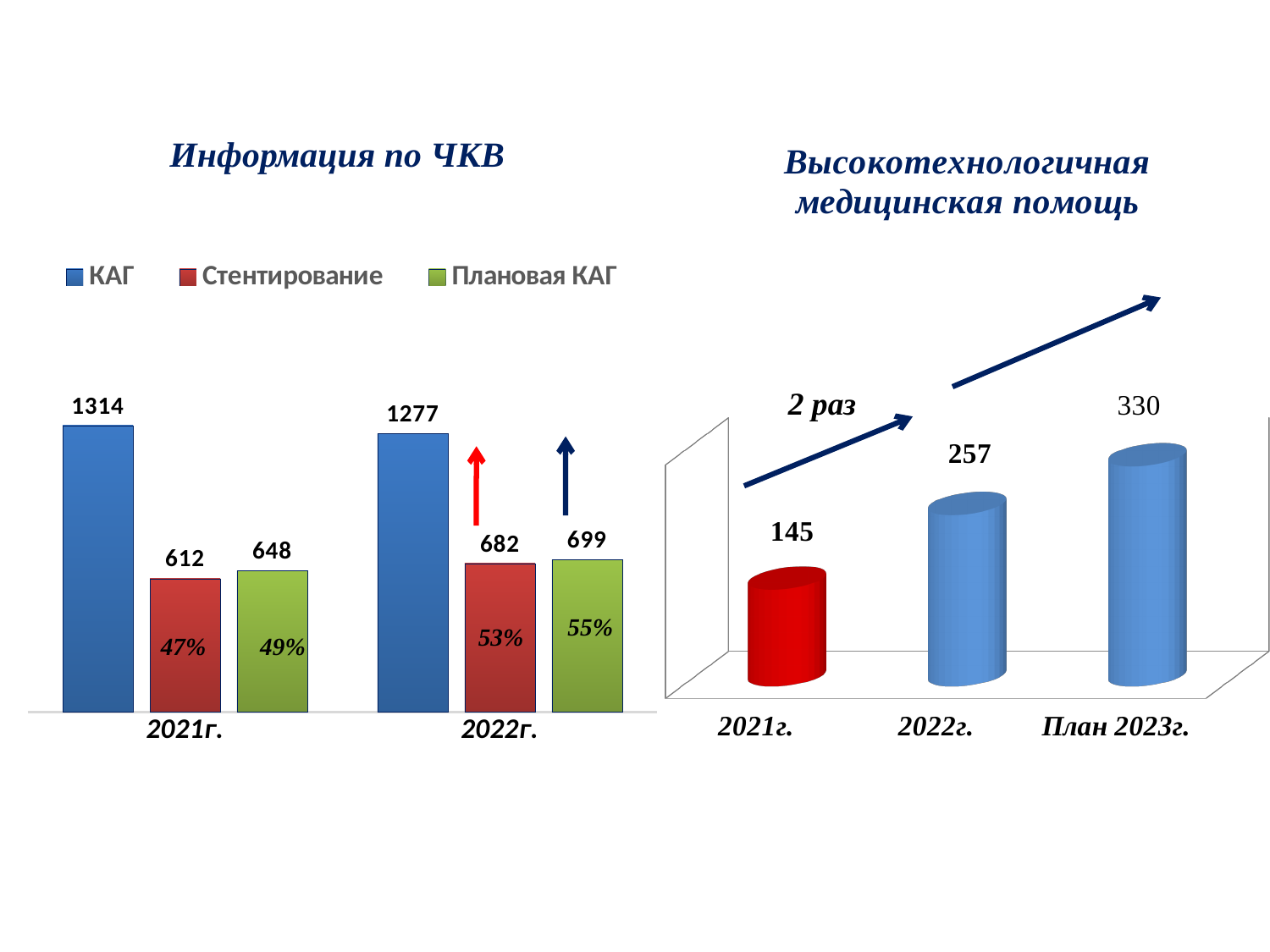
In the chart 'Высокотехнологичная медицинская помощь', what is the difference between План 2023г. and 2021г.? 185 In the chart 'Информация по ЧКВ', what is the value of Плановая КАГ for 2021г.? 648 In the chart 'Информация по ЧКВ', what is the value of КАГ for 2021г.? 1314 In the chart 'Высокотехнологичная медицинская помощь', how many categories are shown on the x axis? 3 In the chart 'Высокотехнологичная медицинская помощь', do the values rise or fall from 2021г. to План 2023г.? rise In the chart 'Высокотехнологичная медицинская помощь', what is the value for 2022г.? 257 In the chart 'Информация по ЧКВ', how many series does the legend list? 3 In the chart 'Информация по ЧКВ', what is the difference between КАГ in 2021г. and КАГ in 2022г.? 37 In the chart 'Информация по ЧКВ', what is the value of Стентирование for 2022г.? 682 In the chart 'Информация по ЧКВ', which is larger: Стентирование in 2021г. or Стентирование in 2022г.? Стентирование in 2022г. In the chart 'Информация по ЧКВ', what percentage is shown on the Плановая КАГ bar for 2022г.? 55% In the chart 'Высокотехнологичная медицинская помощь', which category has the lowest value? 2021г.